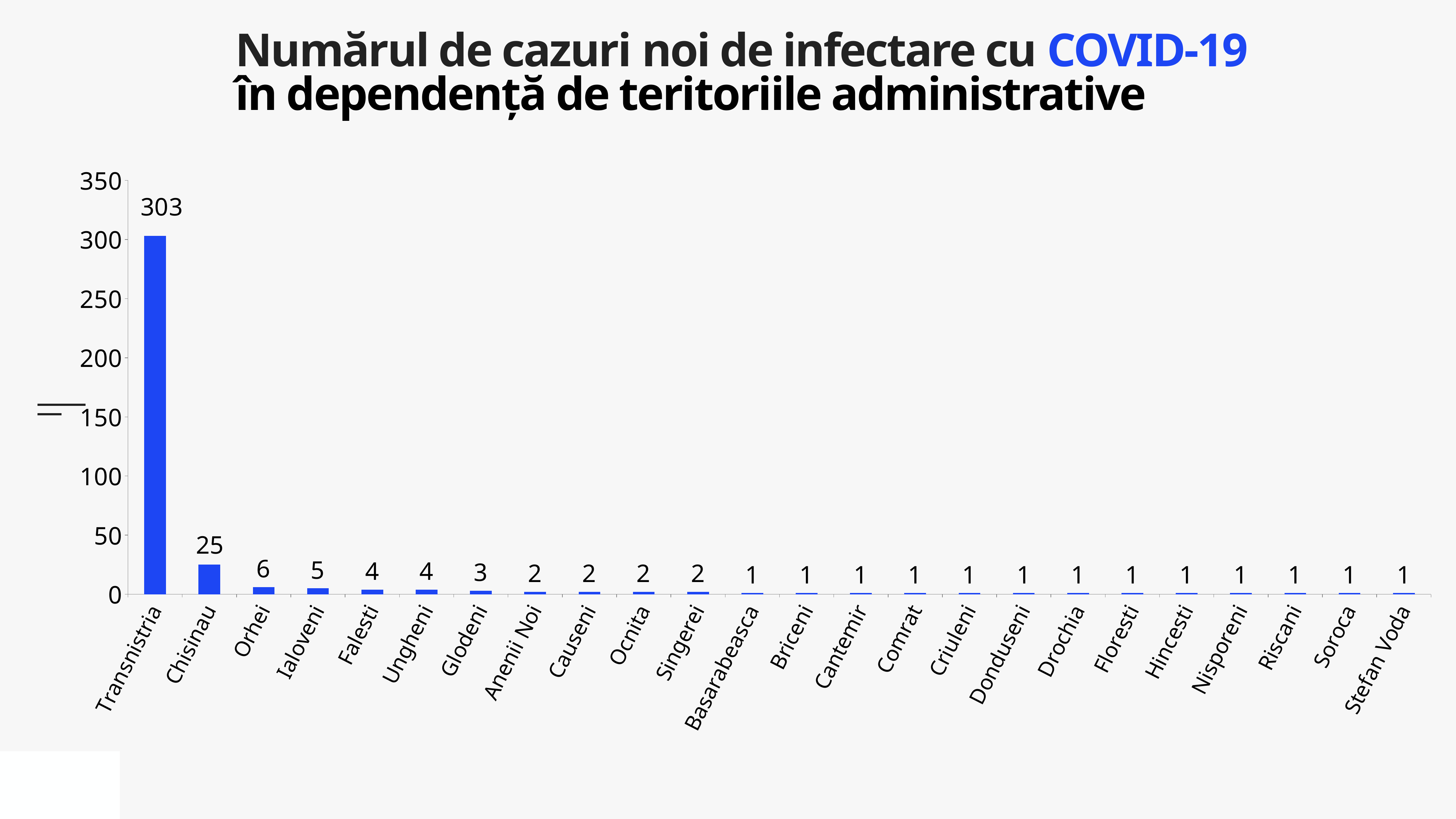
What is the number of new COVID-19 cases for Chisinau? 25 What is the number of new COVID-19 cases for Transnistria? 303 How many territories are shown on the x axis? 24 Which territory has the highest number of new cases? Transnistria What is the value shown for Orhei? 6 Do the values rise or fall moving from left to right along the x axis? fall Which has a larger value, Chisinau or Orhei? Chisinau What is the difference between the values for Orhei and Ialoveni? 1 What is the difference between the values for Transnistria and Chisinau? 278 What kind of chart is shown on the slide? bar chart Is the value for Transnistria greater or less than 300? greater What is the value shown for Glodeni? 3